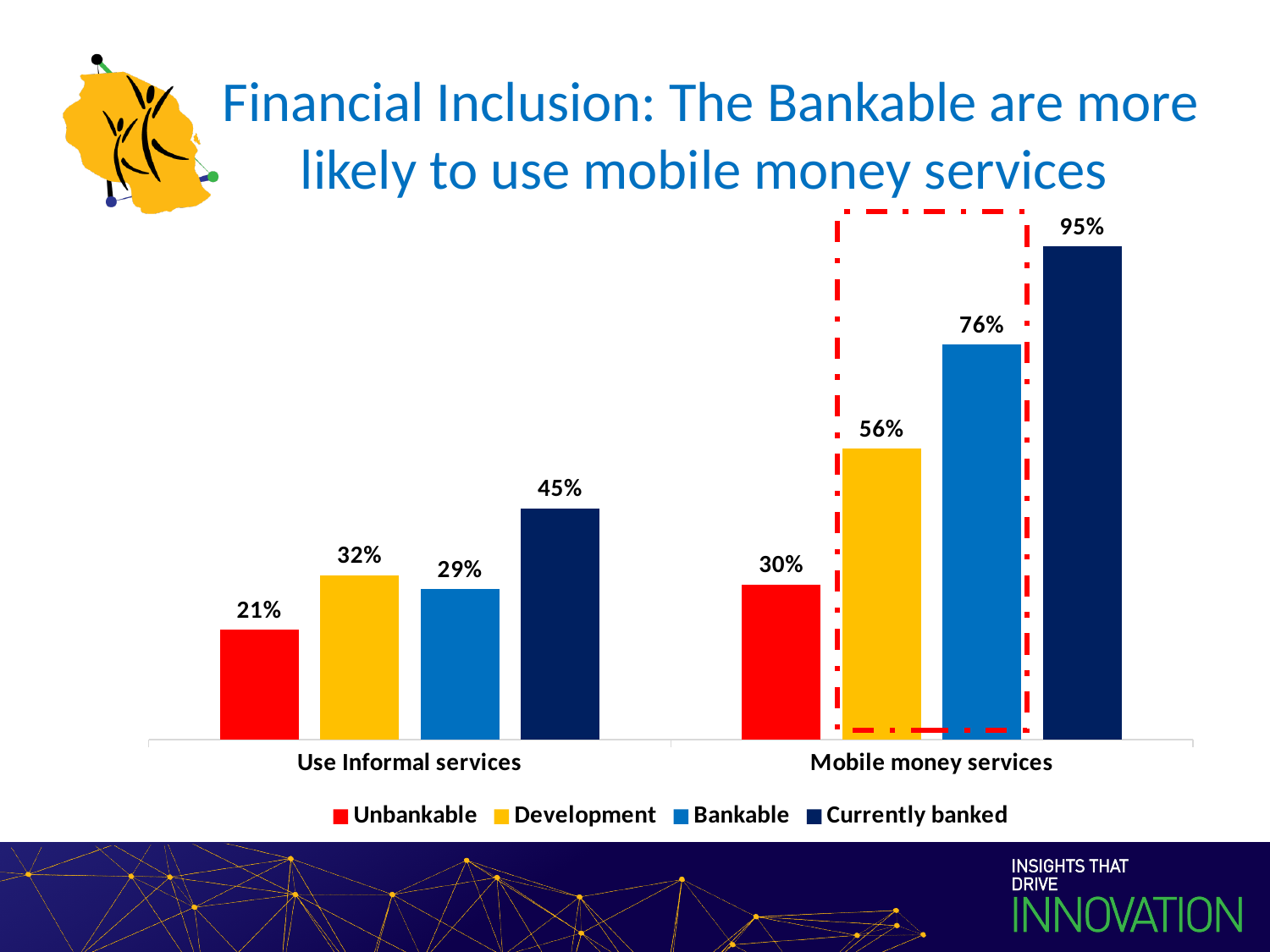
What is the difference between the Development and Bankable values under Use Informal services? 3% What is the value for Bankable under Mobile money services? 76% What is the difference between the Currently banked and Bankable values under Mobile money services? 19% Which series has the lowest value under Use Informal services? Unbankable What is the value for Currently banked under Use Informal services? 45% What is the value for Development under Mobile money services? 56% How many series does the legend list? 4 What kind of chart is shown on the slide? Bar chart Which is larger: the Unbankable value under Use Informal services or under Mobile money services? Mobile money services Which series has the highest value under Mobile money services? Currently banked Which series is shown in red in the legend? Unbankable What is the value for Unbankable under Use Informal services? 21%